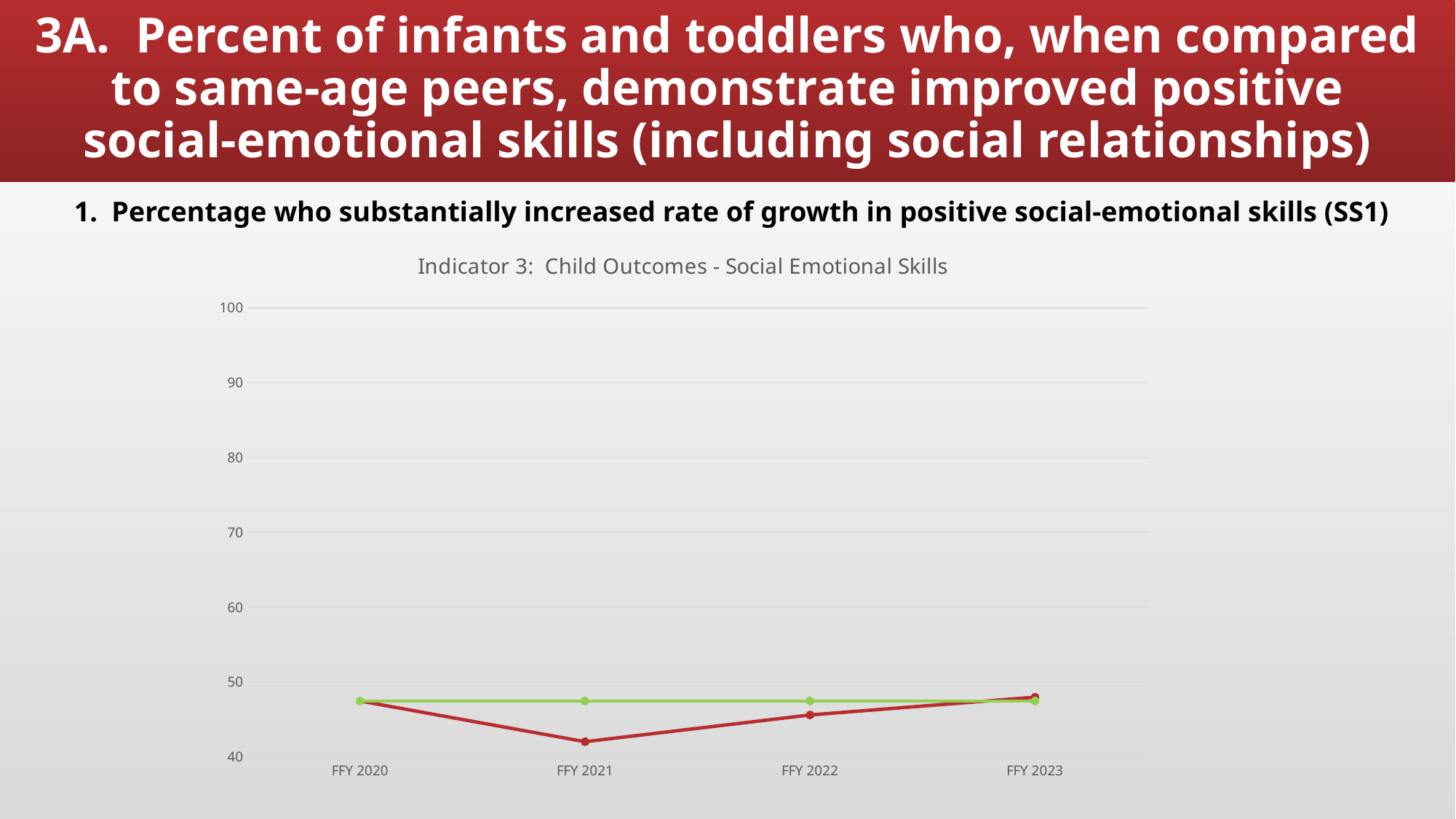
At FFY 2022, which line has the higher value, the red line or the green line? the green line In which fiscal year does the red line reach its lowest value? FFY 2021 At FFY 2021, which line has the higher value, the red line or the green line? the green line How many lines are plotted on the chart? 2 What is the highest value shown on the y axis of the chart? 100 Does the red line rise or fall from FFY 2021 to FFY 2023? rises What is the title of the chart? Indicator 3: Child Outcomes - Social Emotional Skills Is the value of the red line for FFY 2021 greater or less than 40? greater Is the value of the red line for FFY 2021 greater or less than 50? less Is the value of the green line for FFY 2020 greater or less than 50? less How many fiscal years are shown on the x axis of the chart? 4 What kind of chart is shown on the slide? line chart